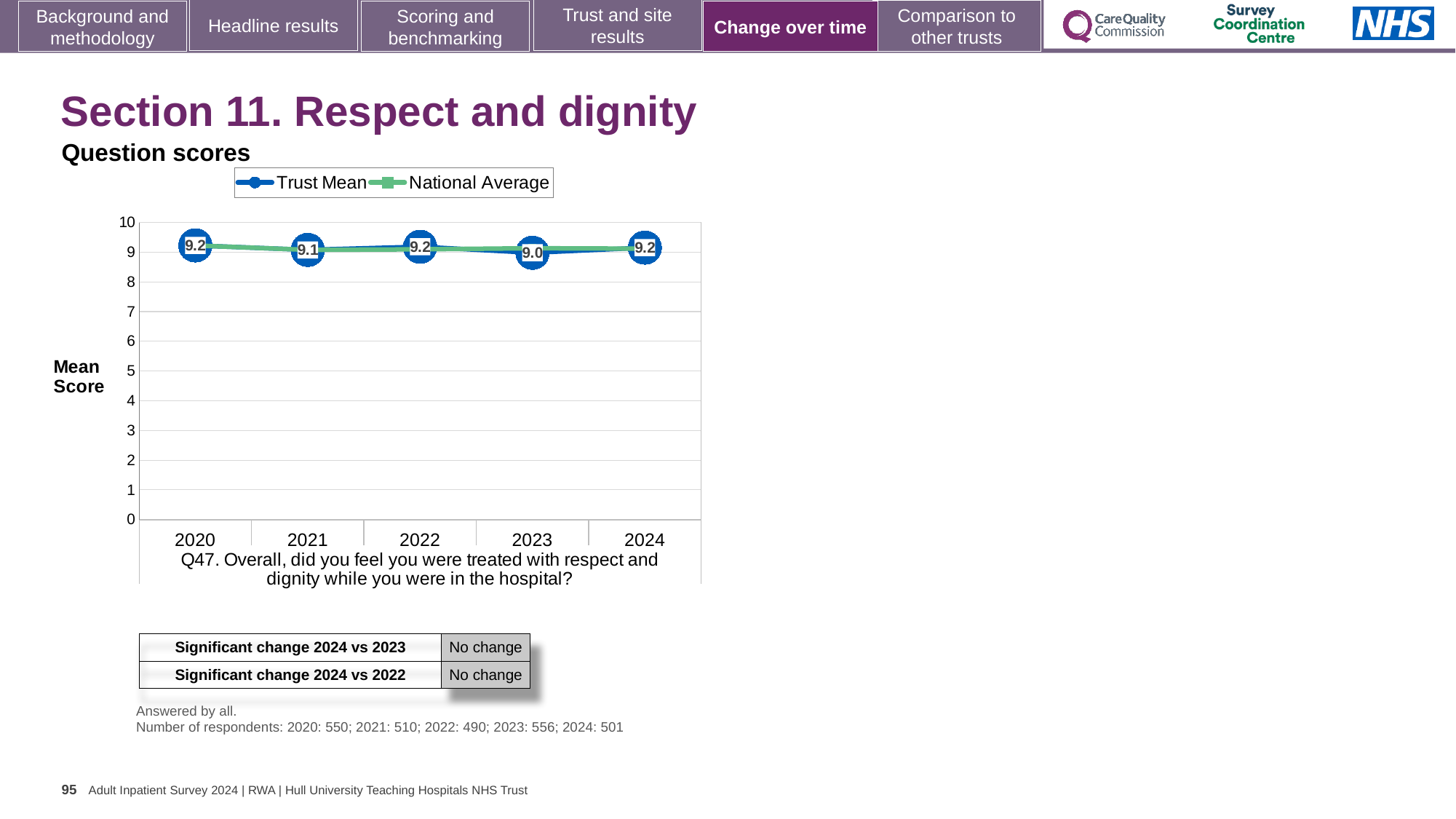
How many years are plotted on the x axis of the chart? 5 Which is larger, the Trust Mean score for 2021 or for 2023? 2021 What is the difference between the Trust Mean score in 2024 and in 2023? 0.2 What is the Trust Mean score for 2020? 9.2 How many series does the chart legend list? 2 What is the Trust Mean score for 2023? 9.0 What is the Trust Mean score for 2021? 9.1 In which year is the Trust Mean score lowest? 2023 What is the Trust Mean score for 2024? 9.2 Is the National Average value for 2022 greater or less than 8? greater What are the two series named in the chart legend? Trust Mean and National Average What kind of chart is shown on the slide? Line chart